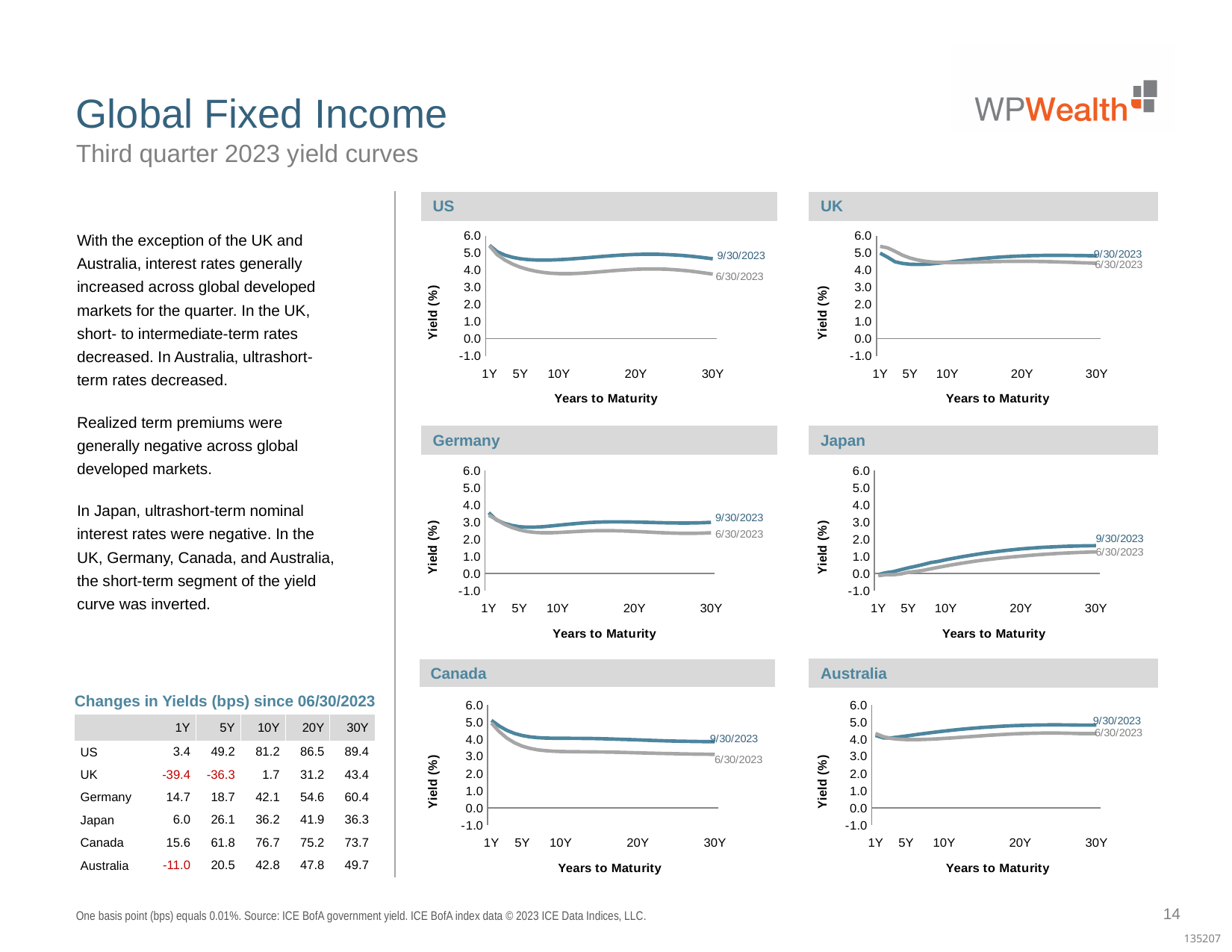
In the US chart, is the 9/30/2023 value at 1Y greater or less than 5.0? greater In the Japan chart, is the 9/30/2023 value at 30Y greater or less than 3.0? less In the Germany chart, is the 6/30/2023 value at 10Y greater or less than 3.0? less What kind of chart is the US chart? line chart In the US chart, which series is higher at 10Y, 9/30/2023 or 6/30/2023? 9/30/2023 How many maturity points are labelled on the x axis of the Canada chart? 5 What is the x-axis title of the Germany chart? Years to Maturity How many series are plotted in the Japan chart? 2 How many yield-curve charts are shown on the slide? 6 In the Canada chart, does the 9/30/2023 line rise or fall from 1Y to 30Y? falls In the Japan chart, does the 9/30/2023 line rise or fall from 1Y to 30Y? rises